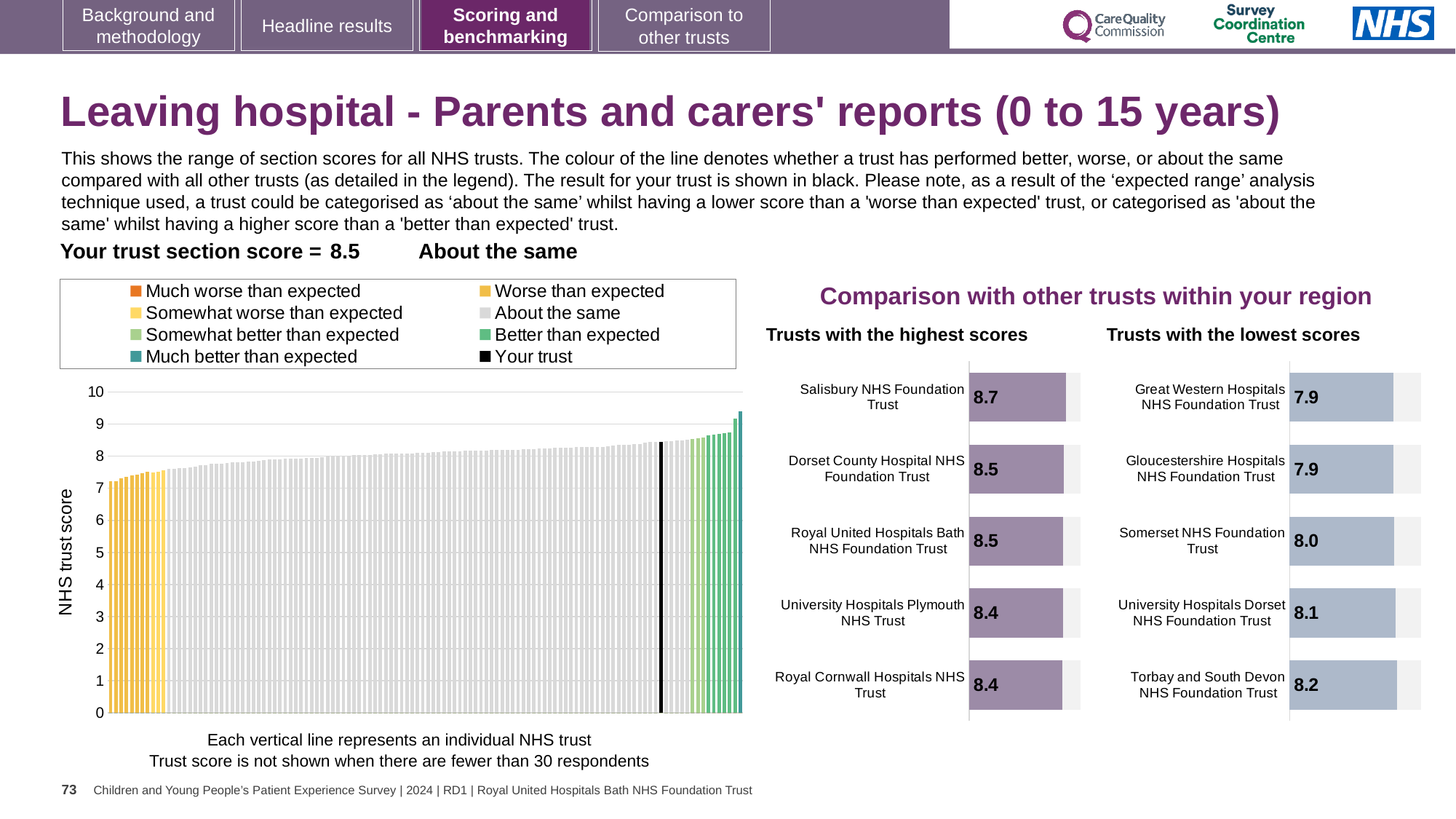
How many trusts are shown in the 'Trusts with the lowest scores' chart? 5 What kind of chart is the main 'NHS trust score' chart on the left? Bar chart In the 'Trusts with the lowest scores' chart, which trust has the highest score? Torbay and South Devon NHS Foundation Trust Which has a higher score: Salisbury NHS Foundation Trust in the highest scores chart or Torbay and South Devon NHS Foundation Trust in the lowest scores chart? Salisbury NHS Foundation Trust In the 'Trusts with the highest scores' chart, what is the score for University Hospitals Plymouth NHS Trust? 8.4 In the main 'NHS trust score' chart on the left, how many entries does the legend list? 8 In the 'Trusts with the highest scores' chart, what is the difference between the scores of Salisbury NHS Foundation Trust and Royal Cornwall Hospitals NHS Trust? 0.3 In the main 'NHS trust score' chart on the left, is the value of the tallest bar greater or less than 9? greater In the 'Trusts with the lowest scores' chart, what is the difference between the scores of Torbay and South Devon NHS Foundation Trust and Great Western Hospitals NHS Foundation Trust? 0.3 In the 'Trusts with the lowest scores' chart, what is the score for Somerset NHS Foundation Trust? 8.0 In the 'Trusts with the highest scores' chart, what is the score for Salisbury NHS Foundation Trust? 8.7 In the main 'NHS trust score' chart on the left, do the bar values rise or fall from left to right? Rise